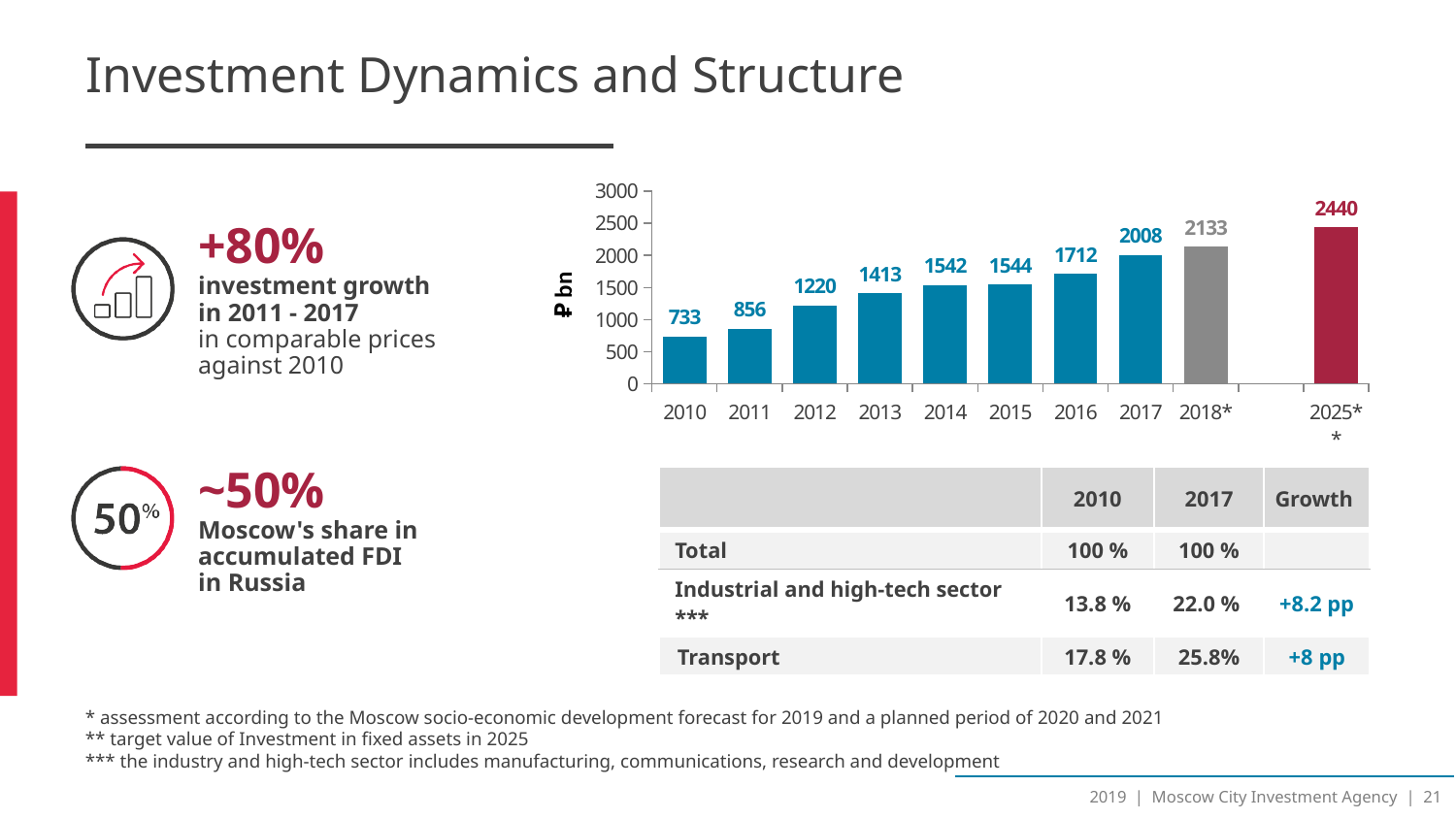
What is the difference between the values for 2017 and 2010 in the bar chart? 1275 What is the value for 2010 in the bar chart? 733 What is the label on the vertical axis of the bar chart? ₽ bn What kind of chart is shown on the slide? bar chart How many bars are plotted in the bar chart? 10 Which is larger in the bar chart, the value for 2013 or the value for 2016? 2016 Which year has the highest value in the bar chart? 2025** Is the value for 2012 in the bar chart greater or less than 1000? greater What is the value for 2017 in the bar chart? 2008 What is the value shown for 2018* in the bar chart? 2133 What is the difference between the values for 2025** and 2018* in the bar chart? 307 Which year has the lowest value in the bar chart? 2010